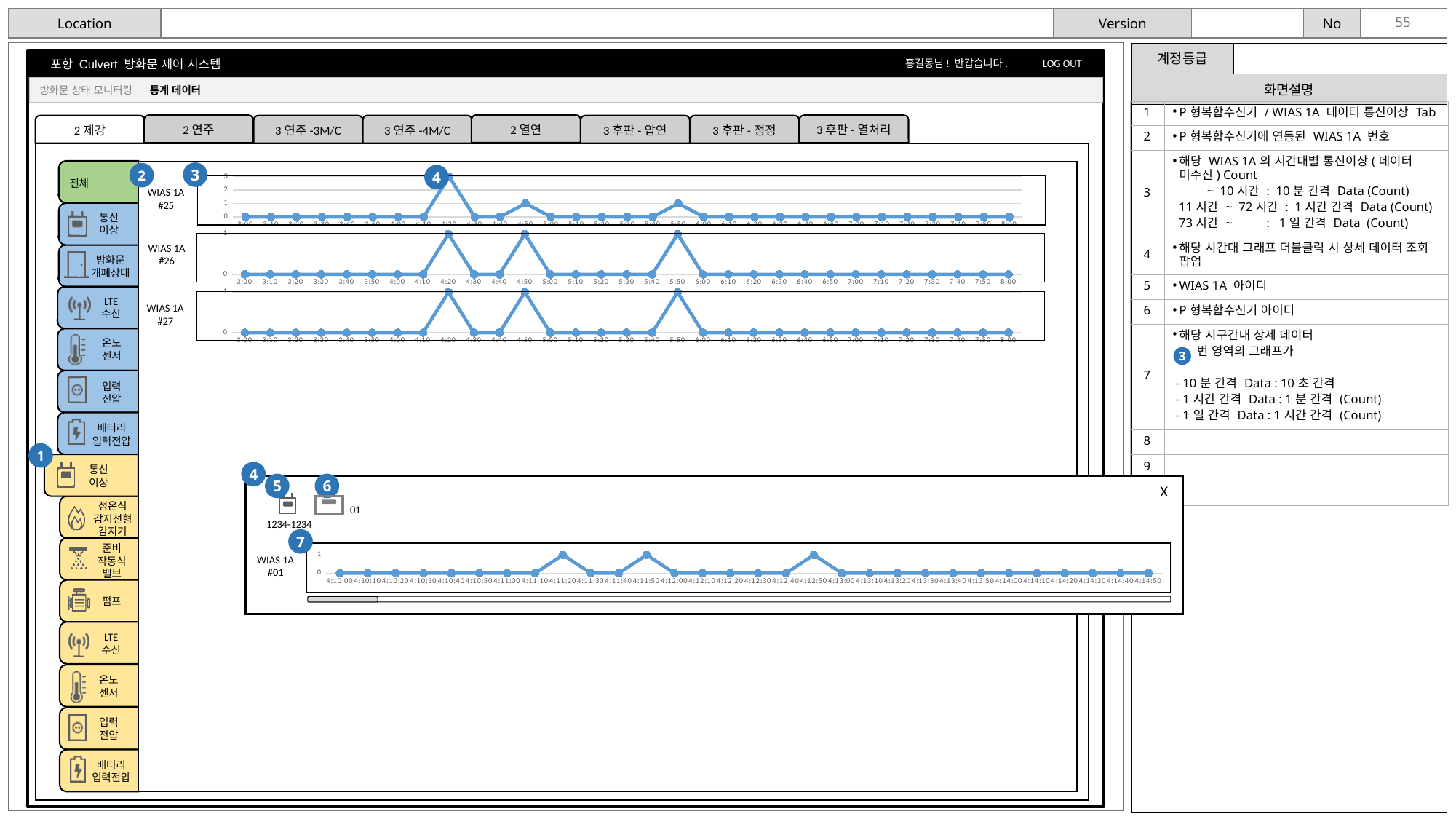
What is the first and last time label on the x axis of the WIAS 1A #25 chart? 3:00 and 8:00 In the WIAS 1A #01 chart in the popup, what is the value at 4:10:00? 0 In the WIAS 1A #27 chart, how many points reach the value 1? 3 In the WIAS 1A #25 chart, what is the value at 4:20? 3 In the WIAS 1A #25 chart, is the value at 4:20 greater or less than 2? greater In the WIAS 1A #25 chart, at which time is the value highest? 4:20 In the WIAS 1A #25 chart, what is the value at 3:00? 0 In the WIAS 1A #25 chart, what is the difference between the value at 4:20 and the value at 4:50? 2 In the WIAS 1A #01 chart in the popup, at which times does the value reach 1? 4:11:20, 4:11:50, 4:12:50 What kind of chart is used for WIAS 1A #25? line chart In the WIAS 1A #26 chart, at which times does the value reach 1? 4:20, 4:50, 5:50 In the WIAS 1A #25 chart, which is larger, the value at 4:20 or the value at 4:50? 4:20